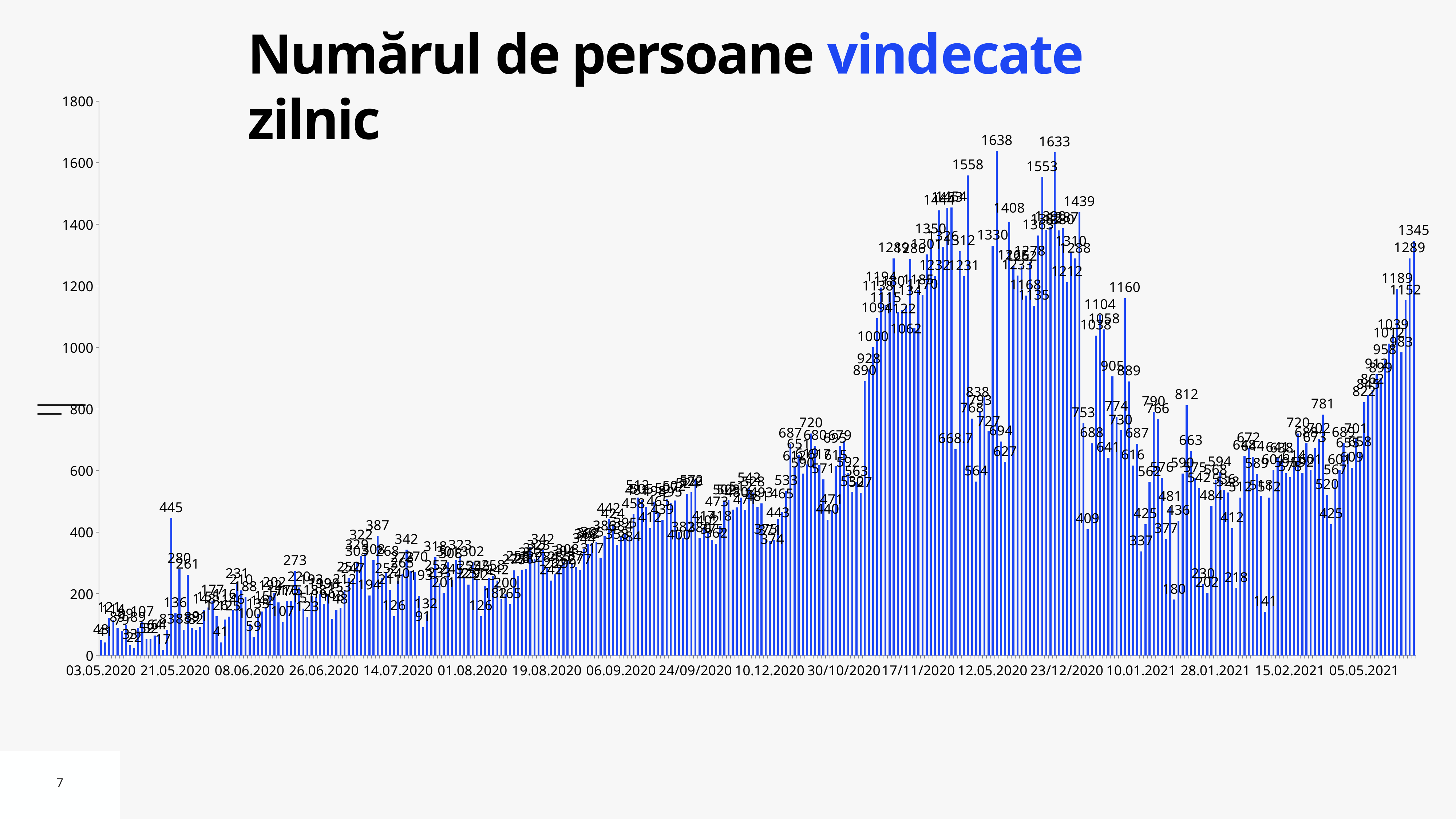
What colour are the bars in the chart? blue What is the first date label on the x axis? 03.05.2020 Overall, do the values rise or fall from the start of the x axis (03.05.2020) to the peak around 17/11/2020? rise What kind of chart is shown on the slide? bar chart What is the highest value labeled among the bars before the 08.06.2020 tick? 445 What is the value of the rightmost bar on the chart? 1345 What is the difference between the highest labeled value, 1638, and the value 1558 labeled shortly before it? 80 Is the highest bar on the chart greater or less than 1600? greater Is the value of the rightmost bar greater or less than 1200? greater What is the highest value labeled on the chart? 1638 What is the last date label on the x axis? 05.05.2021 What is the title of the chart? Numărul de persoane vindecate zilnic